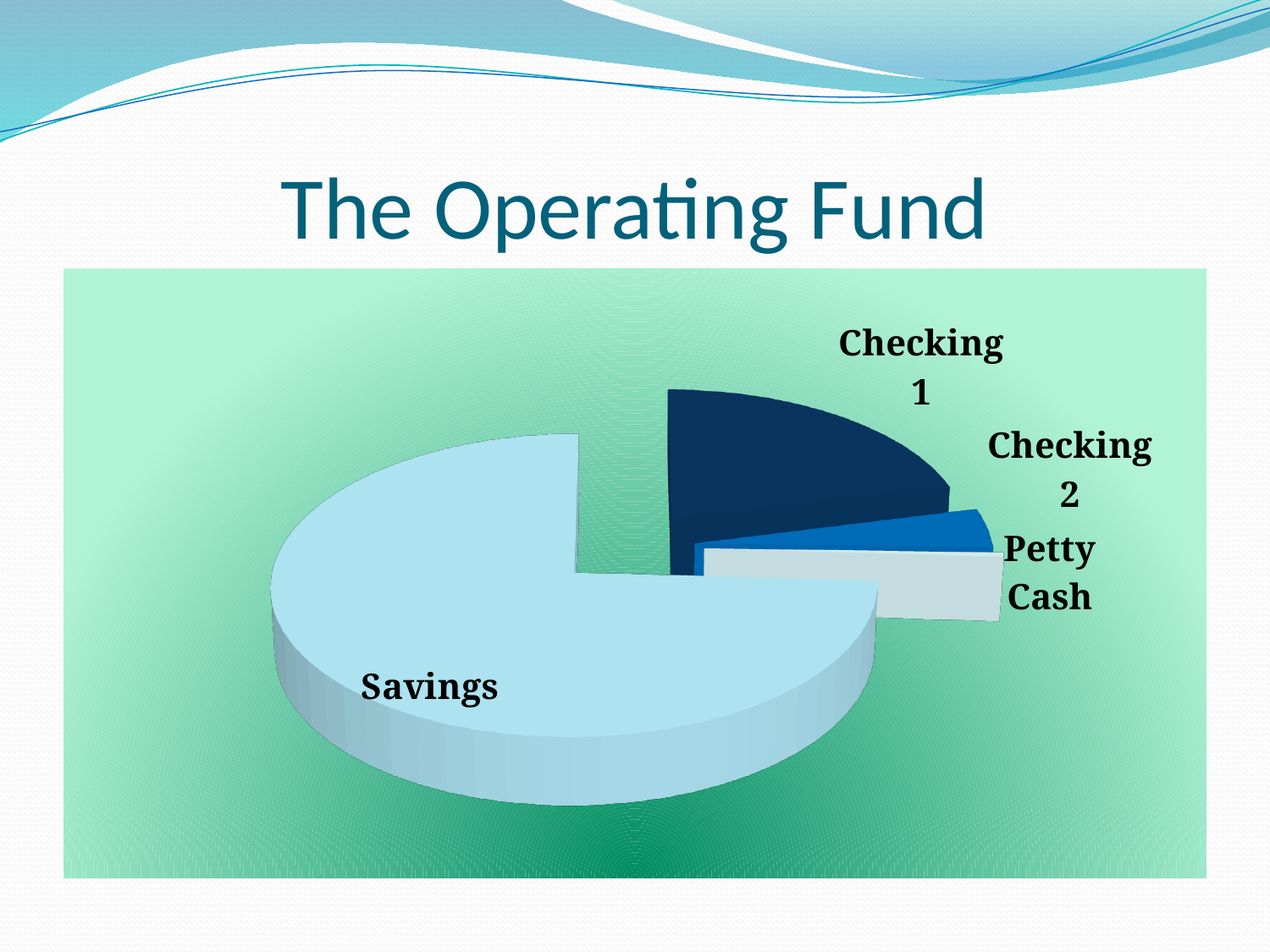
Which is larger, the Savings slice or the Checking 1 slice? Savings Which slice of the pie chart is coloured dark navy blue? Checking 1 What kind of chart is shown on the slide? pie chart Which is larger, the Checking 1 slice or the Petty Cash slice? Checking 1 Which is larger, the Checking 1 slice or the Checking 2 slice? Checking 1 What is the title of the slide containing the pie chart? The Operating Fund How many slices does the pie chart have? 4 Which slice of the pie chart is the largest? Savings Does the Savings slice make up more or less than half of the pie? more